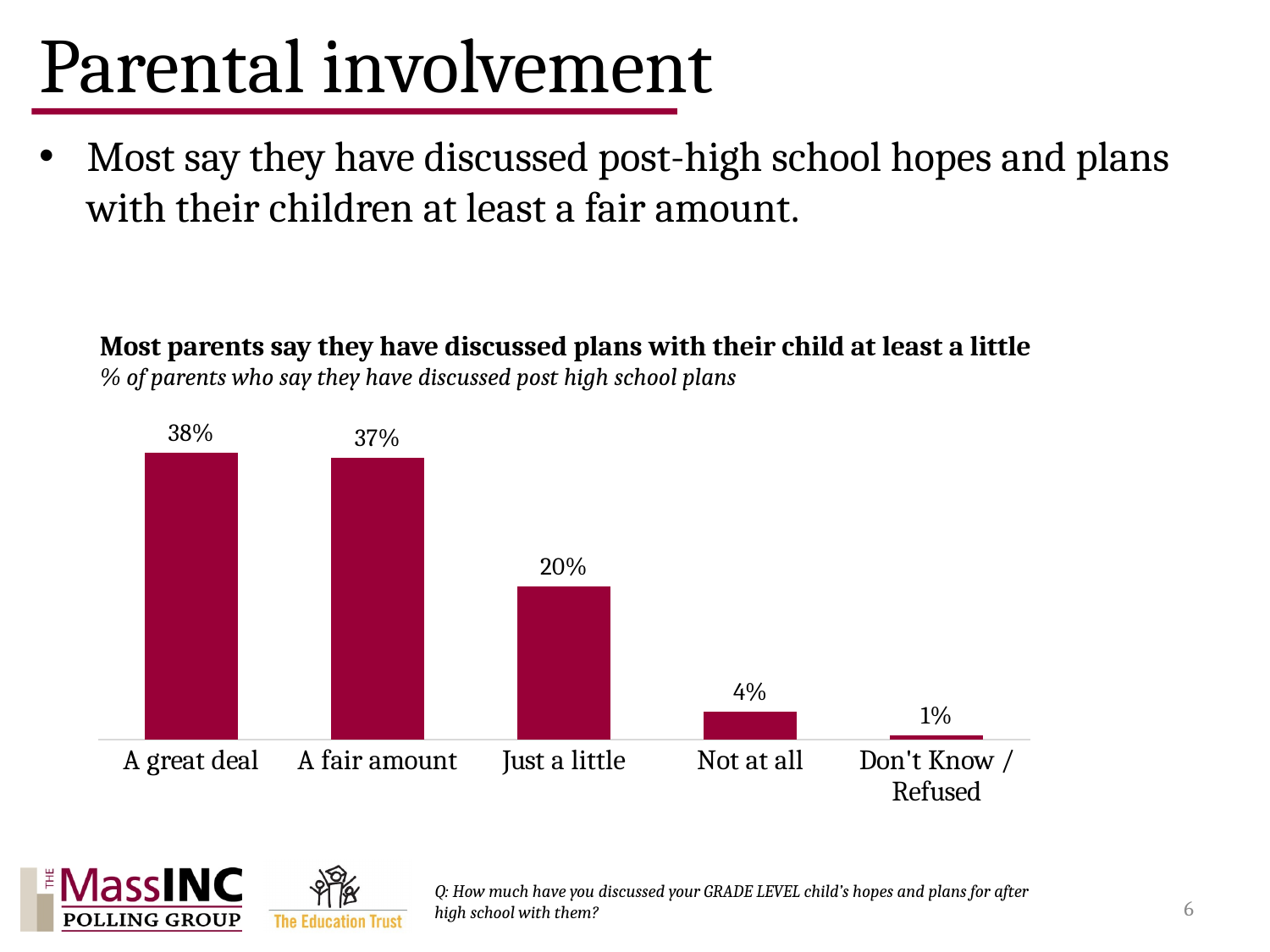
How many categories are shown on the x axis of the chart? 5 What is the difference between the values for 'A fair amount' and 'Just a little'? 17% What kind of chart is shown on the slide? Bar chart Which category has the highest value in the chart? A great deal What is the difference between 'Just a little' and 'Not at all'? 16% What is the value shown for 'Just a little'? 20% Which is larger, the value for 'Just a little' or the value for 'Not at all'? Just a little Which category has the lowest value in the chart? Don't Know / Refused What is the value for 'Don't Know / Refused'? 1% What percentage of parents say they have discussed post high school plans 'A great deal'? 38% Do the values rise or fall moving from left to right along the x axis? Fall What percentage of parents answered 'Not at all'? 4%